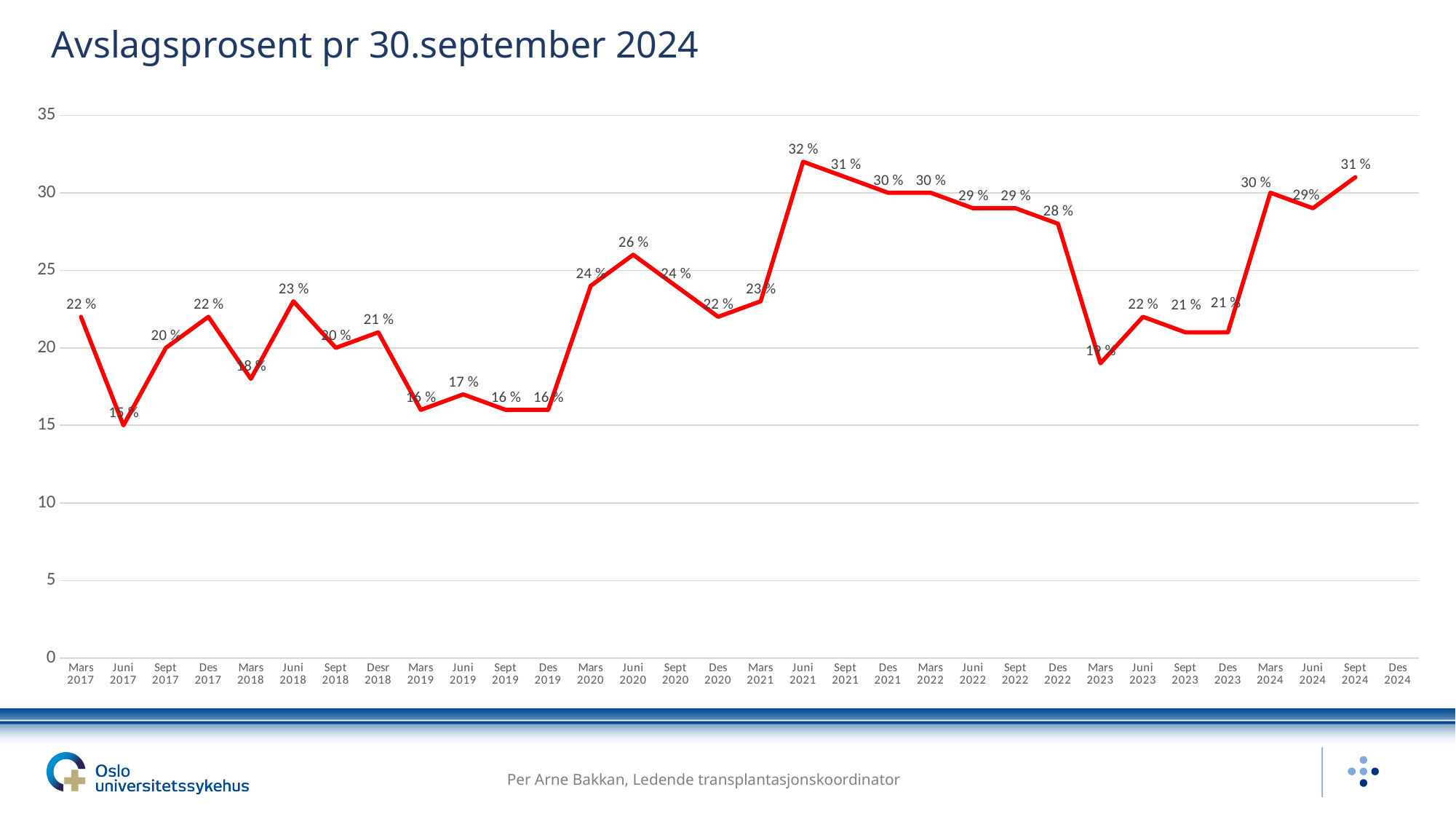
What is the value for Juni 2021? 32 % What is the difference between the values for Sept 2024 and Mars 2017? 9 % Which period has the lowest value? Juni 2017 Which is larger, the value for Mars 2024 or the value for Mars 2023? Mars 2024 What is the title of the chart? Avslagsprosent pr 30.september 2024 Which period has the highest value? Juni 2021 What is the difference between the highest value (Juni 2021) and the lowest value (Juni 2017)? 17 % What kind of chart is shown on the slide? line chart What is the value for Mars 2023? 19 % What is the value for Sept 2024? 31 % Do the values rise or fall from Mars 2023 to Mars 2024? rise Is the value for Des 2022 greater or less than 25? greater